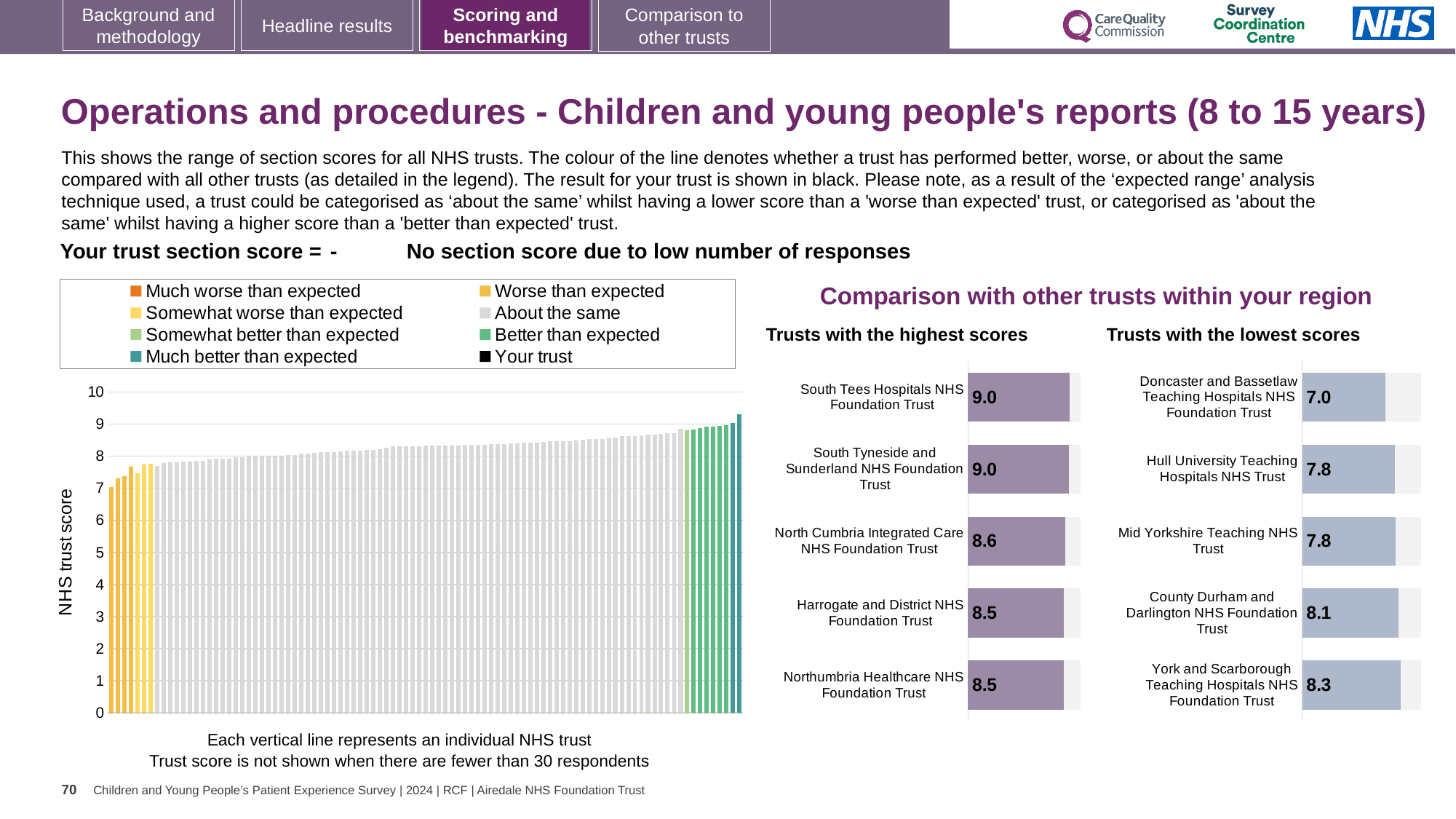
In the 'Trusts with the lowest scores' chart, which has the larger score: Hull University Teaching Hospitals NHS Trust or County Durham and Darlington NHS Foundation Trust? County Durham and Darlington NHS Foundation Trust In the 'NHS trust score' chart on the left, is the value of the tallest bar greater or less than 10? less In the 'Trusts with the lowest scores' chart, what is the difference between the scores of York and Scarborough Teaching Hospitals NHS Foundation Trust and Doncaster and Bassetlaw Teaching Hospitals NHS Foundation Trust? 1.3 In the 'Trusts with the highest scores' chart, what is the difference between the scores of South Tees Hospitals NHS Foundation Trust and Harrogate and District NHS Foundation Trust? 0.5 In the 'Trusts with the lowest scores' chart, which trust has the highest score? York and Scarborough Teaching Hospitals NHS Foundation Trust In the 'Trusts with the lowest scores' chart, which trust has the lowest score? Doncaster and Bassetlaw Teaching Hospitals NHS Foundation Trust In the 'NHS trust score' chart on the left, do the bar values rise or fall from left to right? rise How many entries does the legend above the 'NHS trust score' chart list? 8 In the 'Trusts with the lowest scores' chart, what is the score for Doncaster and Bassetlaw Teaching Hospitals NHS Foundation Trust? 7.0 In the 'Trusts with the highest scores' chart, what is the score for North Cumbria Integrated Care NHS Foundation Trust? 8.6 What kind of chart is the large 'NHS trust score' chart on the left of the slide? Bar chart How many trusts are shown in the 'Trusts with the highest scores' chart? 5